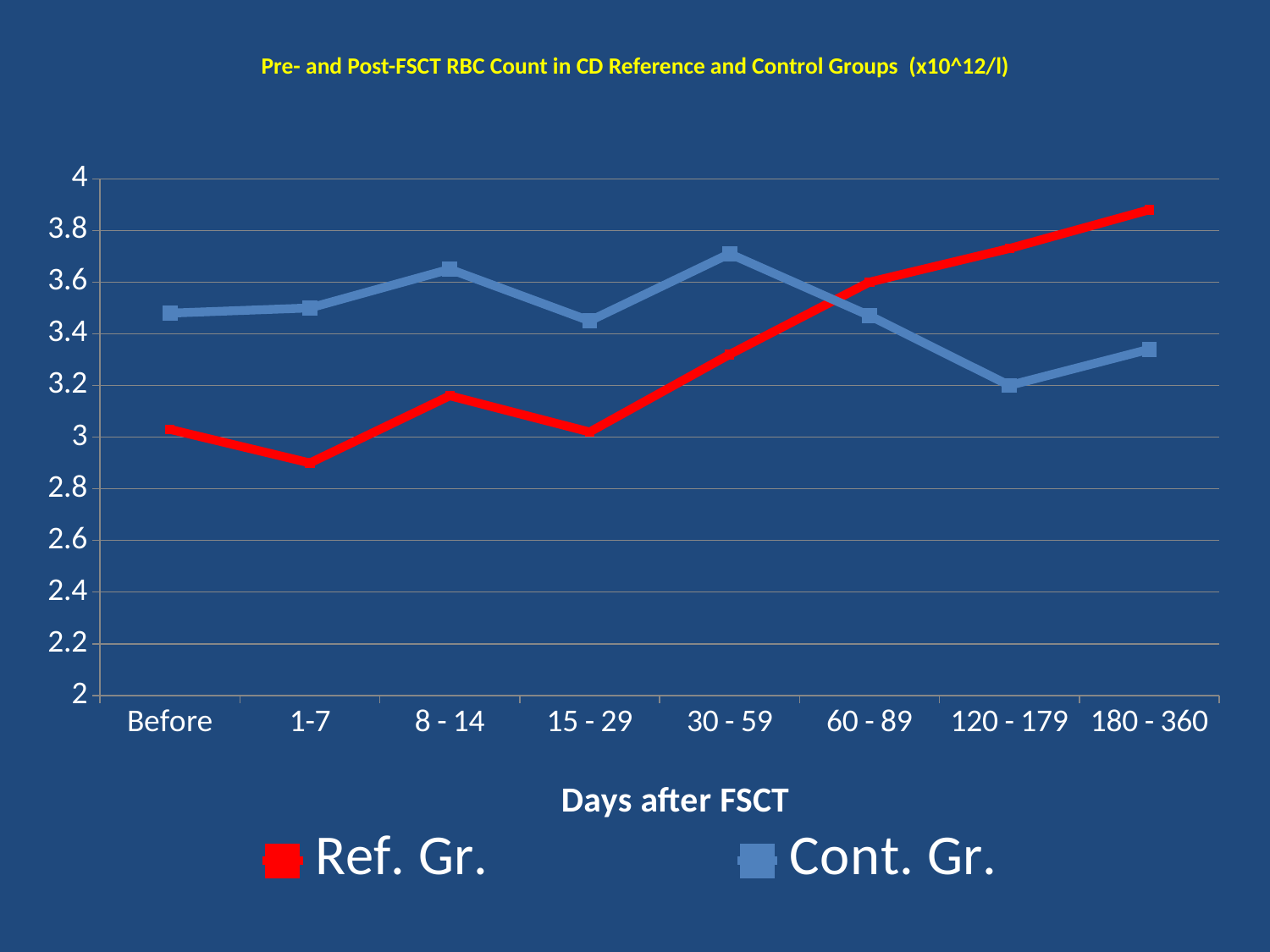
At which time point is the Ref. Gr. value lowest? 1-7 At which time point is the Ref. Gr. value highest? 180 - 360 How many categories are shown along the x axis? 8 Which series has the larger value at 180 - 360, Ref. Gr. or Cont. Gr.? Ref. Gr. What is the label of the x axis? Days after FSCT At which time point is the Cont. Gr. value lowest? 120 - 179 Does the Ref. Gr. line rise or fall from 15 - 29 to 180 - 360? rise At which time point is the Cont. Gr. value highest? 30 - 59 How many series does the legend list? 2 What kind of chart is shown on the slide? line chart Is the Ref. Gr. value at 1-7 greater or less than 3? less Is the Cont. Gr. value at 8 - 14 greater or less than 3.6? greater